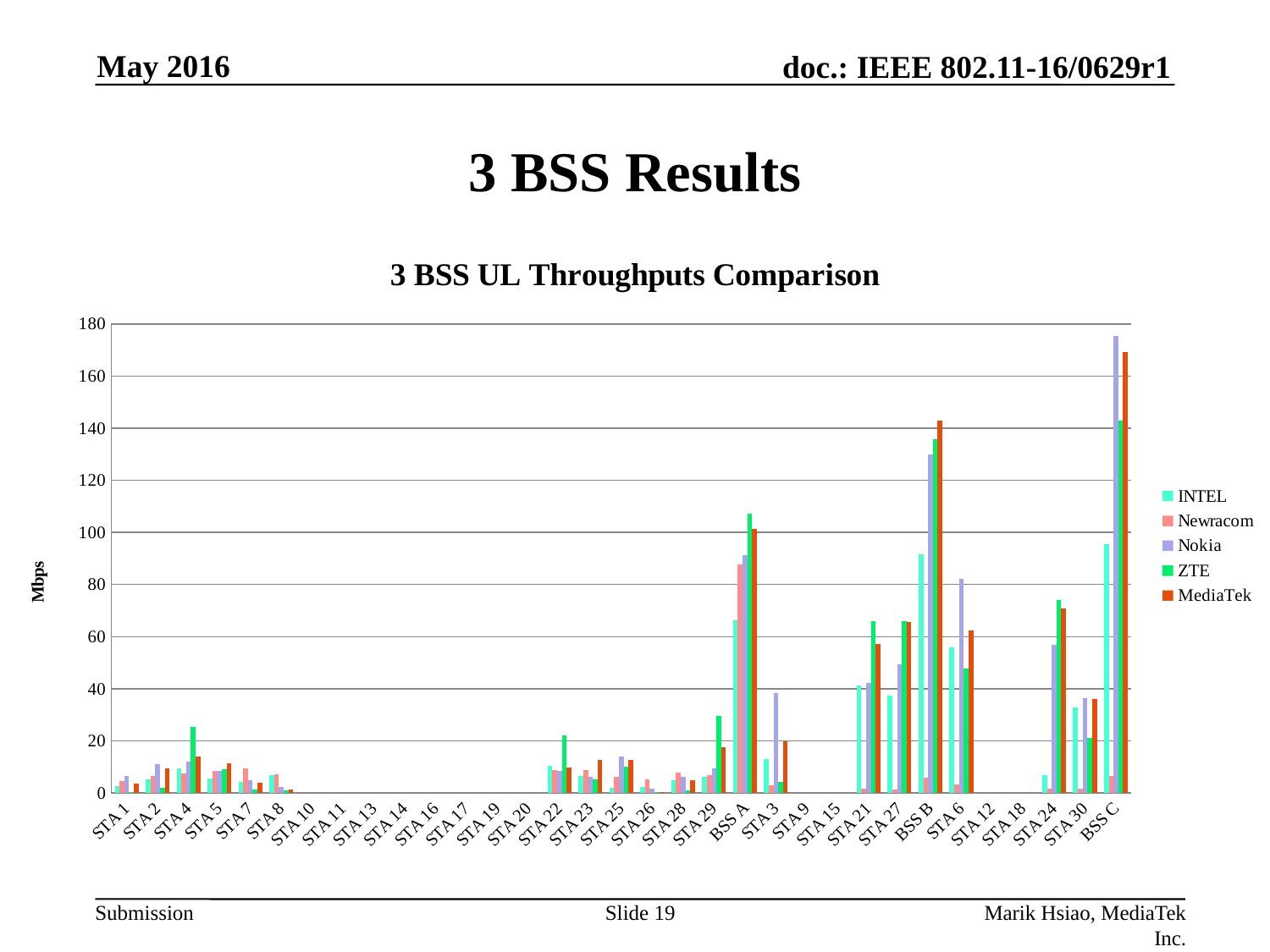
Which series are listed in the legend? INTEL, Newracom, Nokia, ZTE, MediaTek Is the MediaTek value for BSS B greater or less than 140? greater Is the ZTE value for BSS A greater or less than 100? greater How many series does the legend list? 5 Is the INTEL value for STA 30 greater or less than 80? less Which series has the highest value for BSS C? Nokia How many categories are shown along the x axis? 33 Which is larger: the Nokia value for BSS C or the MediaTek value for BSS B? Nokia value for BSS C What kind of chart is shown on the slide? bar chart What is the label on the vertical axis? Mbps Which category has the highest Nokia value? BSS C